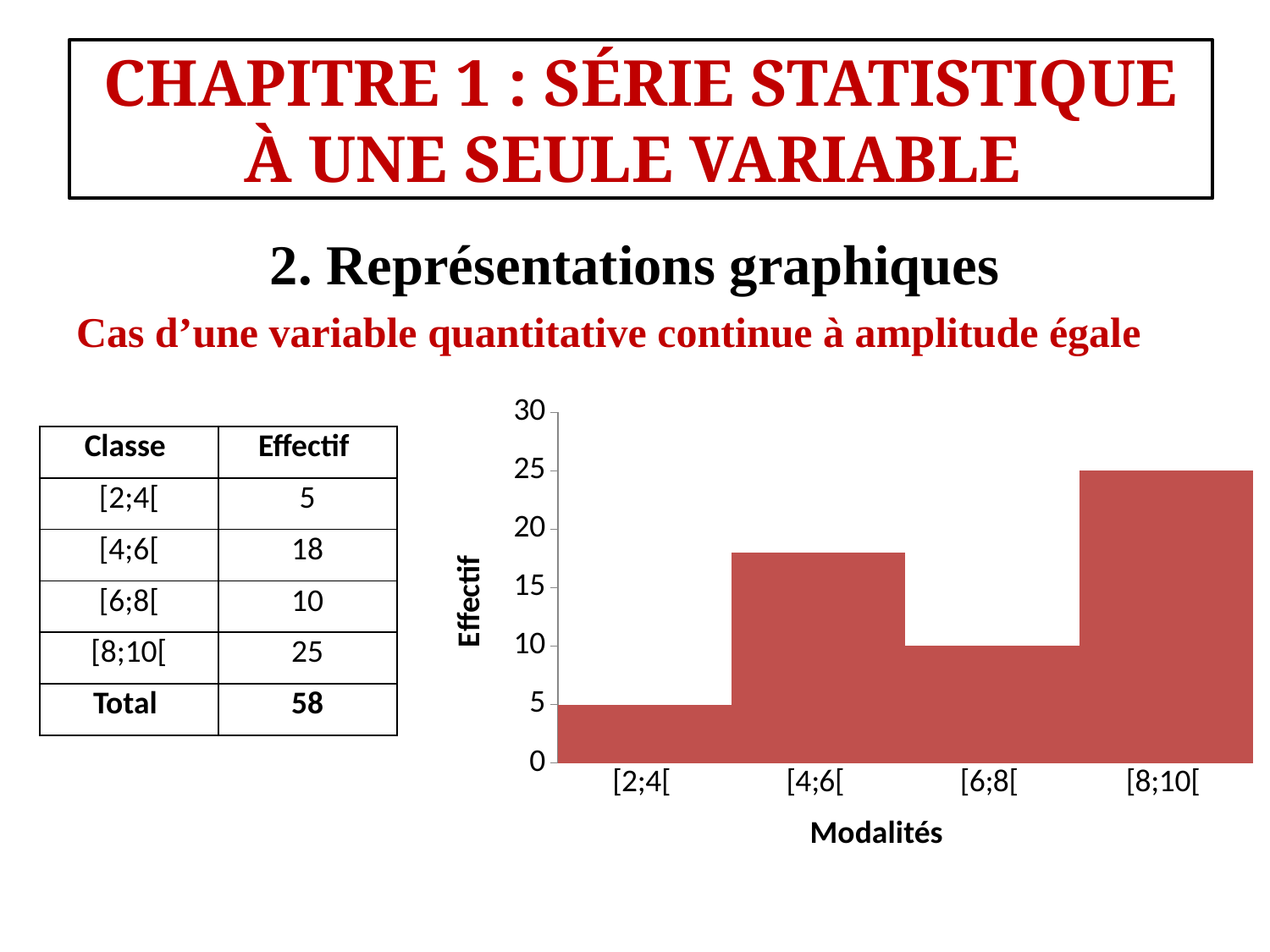
What is the Effectif value for the class [2;4[ in the chart? 5 What is the label of the vertical axis of the chart? Effectif What is the Effectif value for the class [4;6[ in the chart? 18 How many classes are shown on the x axis of the chart? 4 What is the Effectif value for the class [8;10[ in the chart? 25 Which class has the lowest Effectif in the chart? [2;4[ Is the value for [4;6[ greater or less than 15? greater Which class has the highest Effectif in the chart? [8;10[ What is the difference in Effectif between the classes [8;10[ and [4;6[? 7 Which class has a larger Effectif, [4;6[ or [6;8[? [4;6[ What is the Effectif value for the class [6;8[ in the chart? 10 What kind of chart is shown on the slide? bar chart